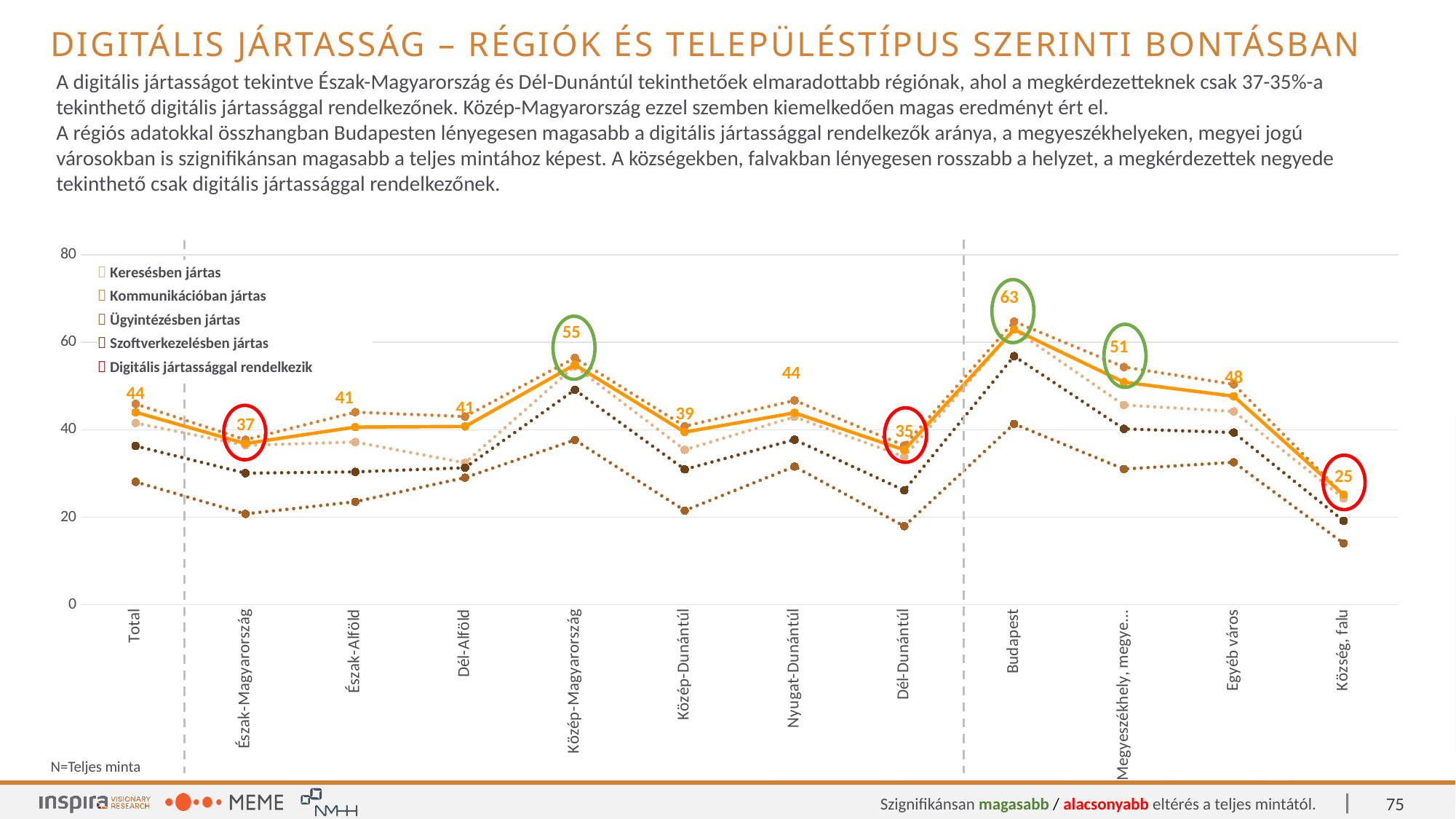
What is the value of the 'Digitális jártassággal rendelkezik' series for Közép-Magyarország? 55 What is the difference between the 'Digitális jártassággal rendelkezik' values for Budapest and Község, falu? 38 Which category has the highest value in the 'Digitális jártassággal rendelkezik' series? Budapest What is the value of the 'Digitális jártassággal rendelkezik' series for Budapest? 63 In the 'Digitális jártassággal rendelkezik' series, which is larger: Észak-Magyarország or Dél-Dunántúl? Észak-Magyarország How many categories are shown on the x axis of the chart? 12 Which category has the lowest value in the 'Digitális jártassággal rendelkezik' series? Község, falu What is the value of the 'Digitális jártassággal rendelkezik' series for Total? 44 Is the 'Digitális jártassággal rendelkezik' value for Megyeszékhely greater or less than 40? greater What is the value of the 'Digitális jártassággal rendelkezik' series for Község, falu? 25 What kind of chart is shown on the slide? Line chart How many series does the chart legend list? 5